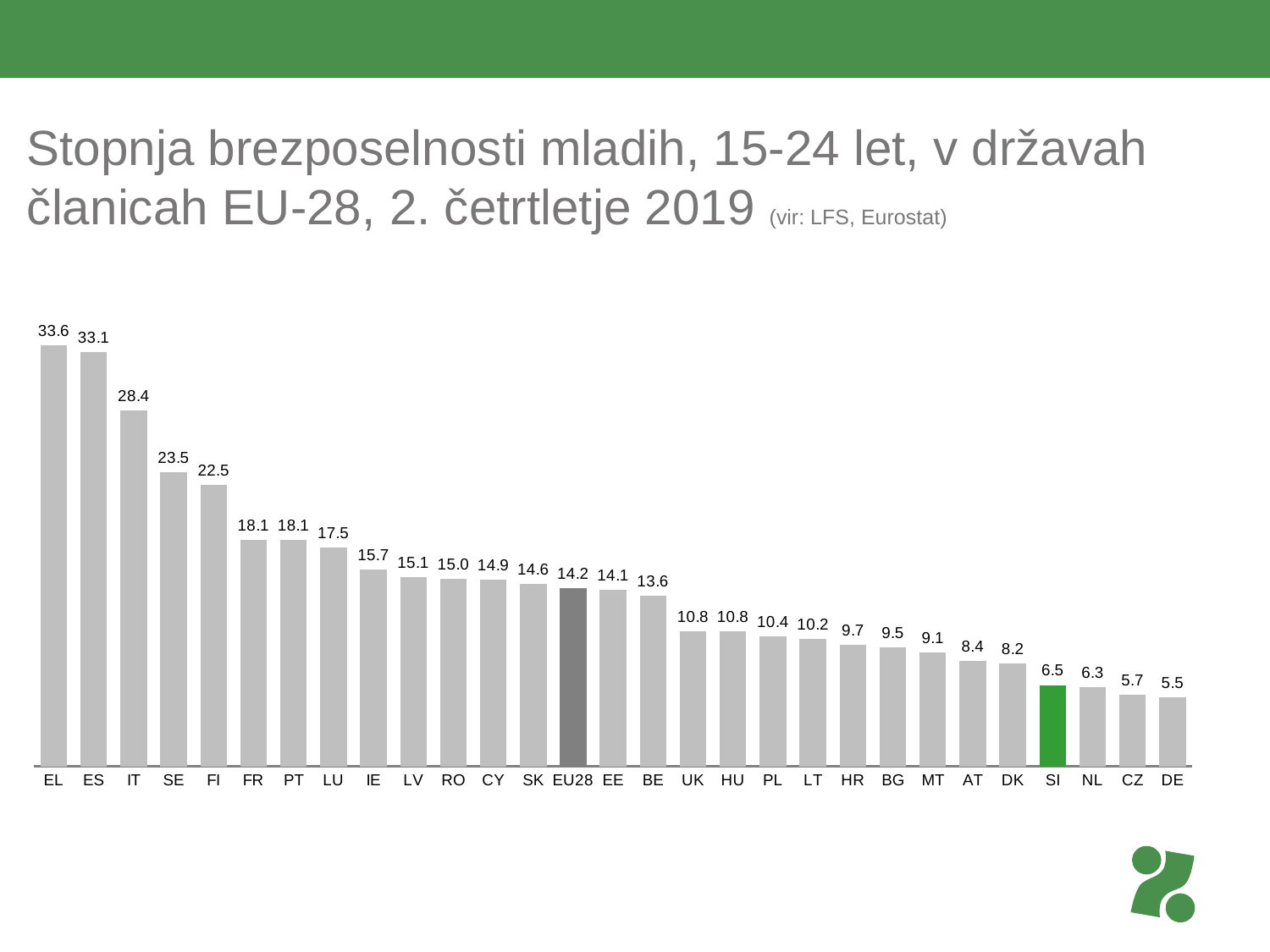
Which country has the highest value on the chart? EL What is the difference between the values for EU28 and SI? 7.7 Do the values rise or fall from left to right along the x axis? Fall What value is shown for EU28? 14.2 What value is shown for IT? 28.4 How many bars are shown on the chart? 29 What is the youth unemployment rate shown for SI? 6.5 Which has a higher value, NL or SI? SI Which country has the lowest value on the chart? DE Which has a higher value, FI or FR? FI What type of chart is shown on the slide? Bar chart What is the difference between the values for EL and ES? 0.5